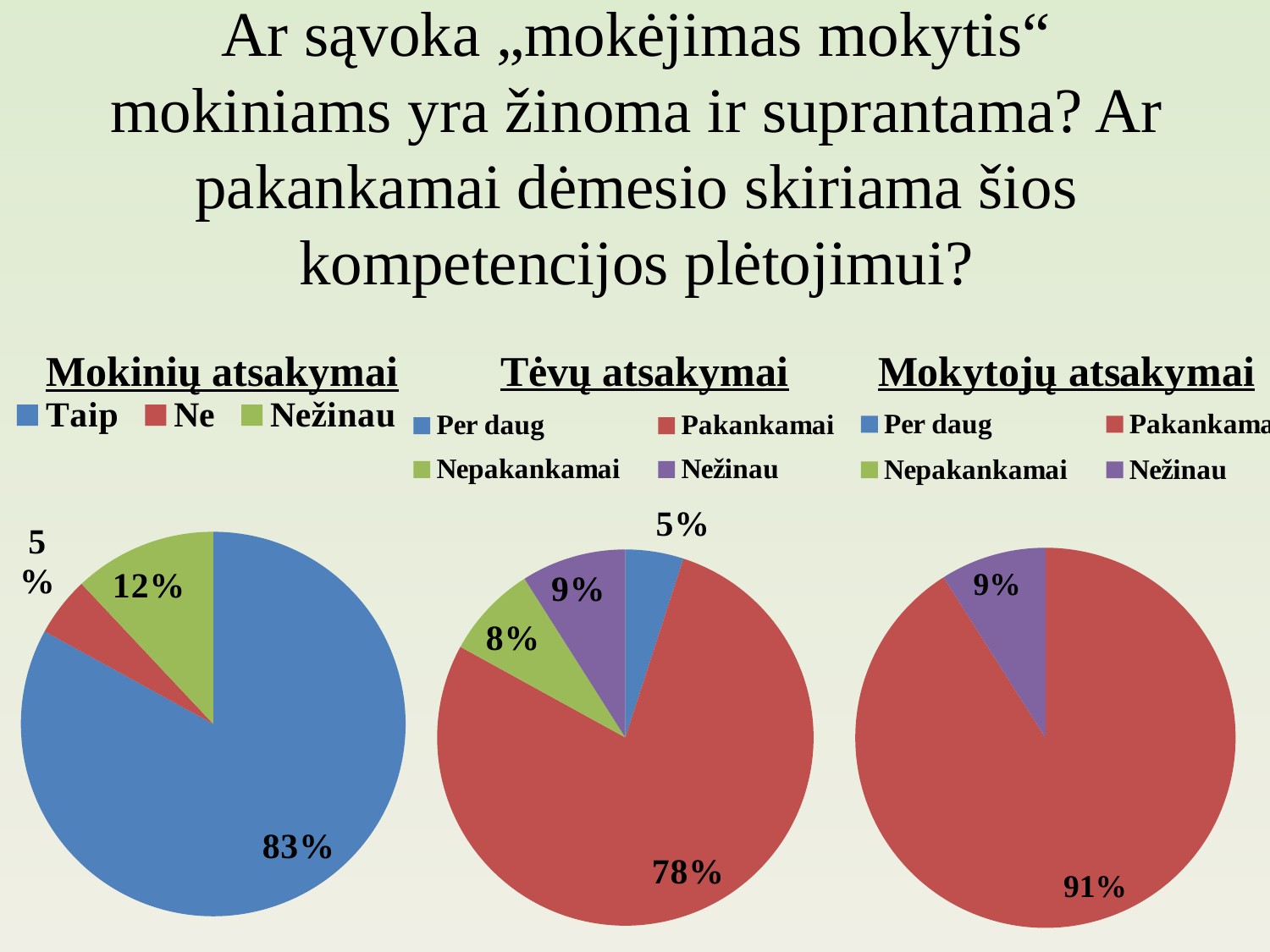
In the 'Tėvų atsakymai' chart, what is the difference between the 'Pakankamai' and 'Nežinau' shares? 69% In the 'Tėvų atsakymai' chart, what percentage answered 'Nepakankamai'? 8% In the 'Mokytojų atsakymai' chart, what percentage answered 'Nežinau'? 9% What type of chart is used for 'Mokytojų atsakymai'? Pie chart In the 'Tėvų atsakymai' chart, what percentage of parents answered 'Pakankamai'? 78% In the 'Mokinių atsakymai' chart, which answer has the smallest share? Ne In the 'Mokinių atsakymai' chart, what percentage of students answered 'Taip'? 83% In the 'Mokinių atsakymai' chart, what percentage answered 'Nežinau'? 12% How many entries does the legend of the 'Tėvų atsakymai' chart list? 4 Which is larger: the 'Nežinau' share in the 'Mokinių atsakymai' chart or the 'Nežinau' share in the 'Tėvų atsakymai' chart? Mokinių atsakymai In the 'Mokytojų atsakymai' chart, what percentage of teachers answered 'Pakankamai'? 91% In the 'Tėvų atsakymai' chart, which answer has the largest share? Pakankamai